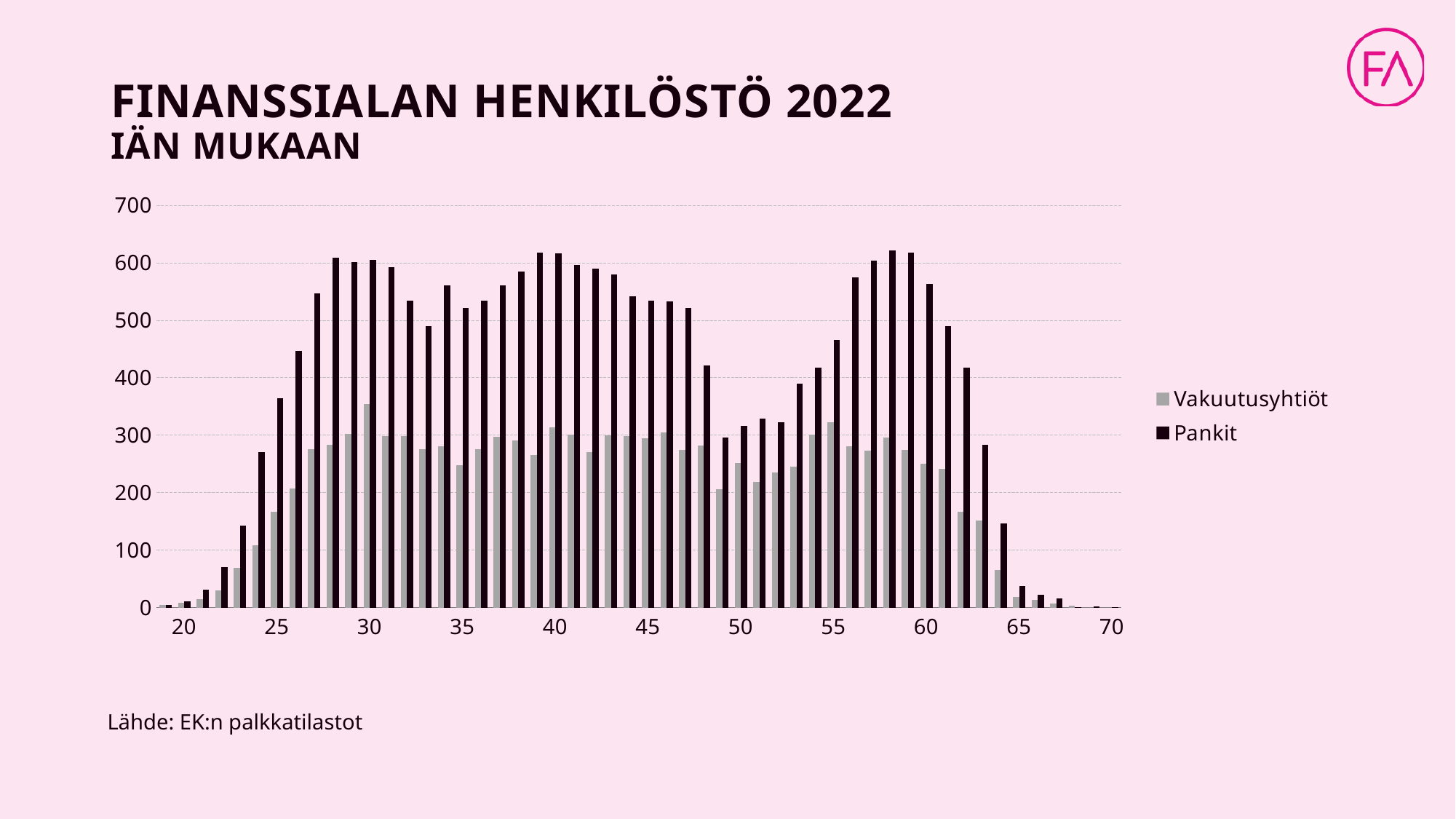
Do the Pankit values rise or fall from age 60 to age 65? fall Is the value for Pankit at age 50 greater or less than 400? less At age 40, which series has the larger value, Vakuutusyhtiöt or Pankit? Pankit Is the value for Vakuutusyhtiöt at age 30 greater or less than 300? greater Is the value for Pankit at age 40 greater or less than 600? greater How many series does the legend list? 2 What is the source given below the chart? EK:n palkkatilastot What are the two series named in the legend? Vakuutusyhtiöt and Pankit What kind of chart is shown on the slide? bar chart